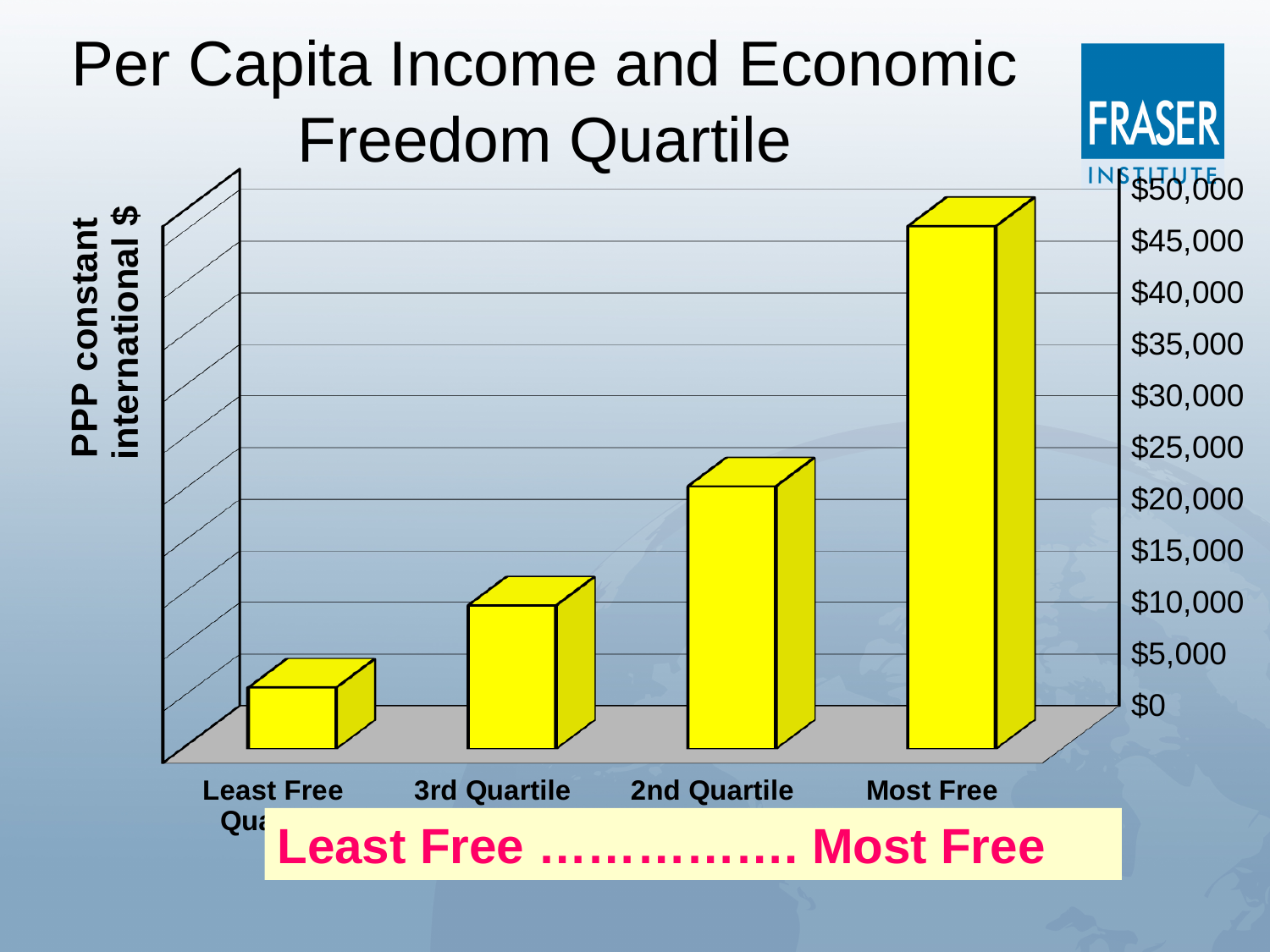
Which quartile has the lowest per capita income? Least Free Quartile Which has a higher per capita income, the 2nd Quartile or the 3rd Quartile? 2nd Quartile Is the value for the Least Free Quartile greater or less than $10,000? less Do the bars rise or fall moving from Least Free to Most Free along the x axis? rise What kind of chart is shown on the slide? bar chart What is the title of the chart? Per Capita Income and Economic Freedom Quartile What is the label on the vertical axis? PPP constant international $ Is the value for Most Free greater or less than $40,000? greater Which quartile has the highest per capita income? Most Free Is the value for the 2nd Quartile greater or less than $15,000? greater How many quartile categories are plotted in the chart? 4